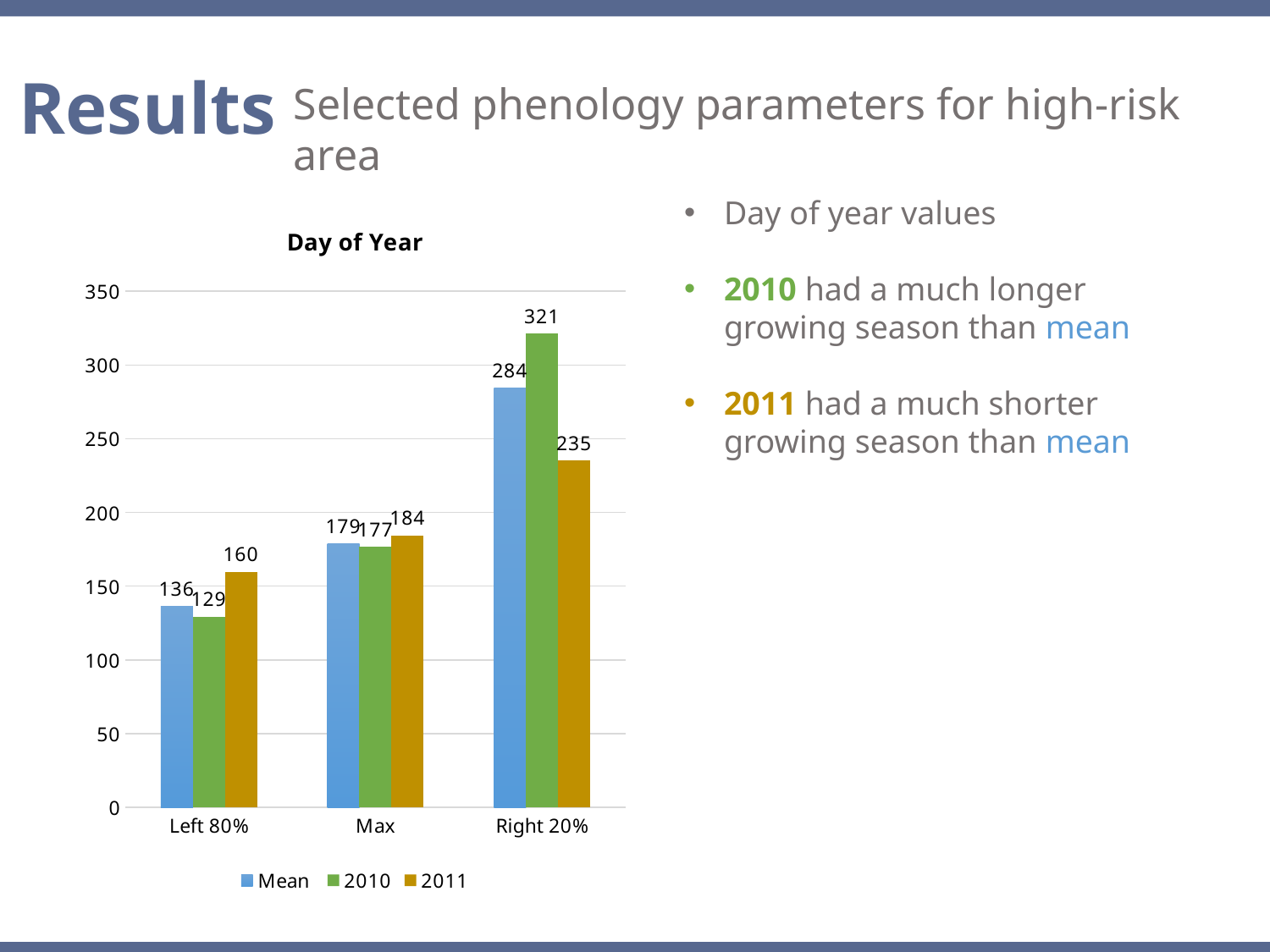
How many series does the legend list? 3 What is the Mean value for Left 80%? 136 For Left 80%, which is larger: the 2010 value or the 2011 value? 2011 Is the Mean value for Right 20% greater or less than 250? greater What kind of chart is shown? bar chart What is the difference between the 2010 and 2011 values for Right 20%? 86 What is the 2010 value for Right 20%? 321 What is the title of the chart? Day of Year Which category has the highest 2011 value? Right 20% What is the 2011 value for Max? 184 How many categories are shown on the x axis? 3 Which category has the lowest 2010 value? Left 80%